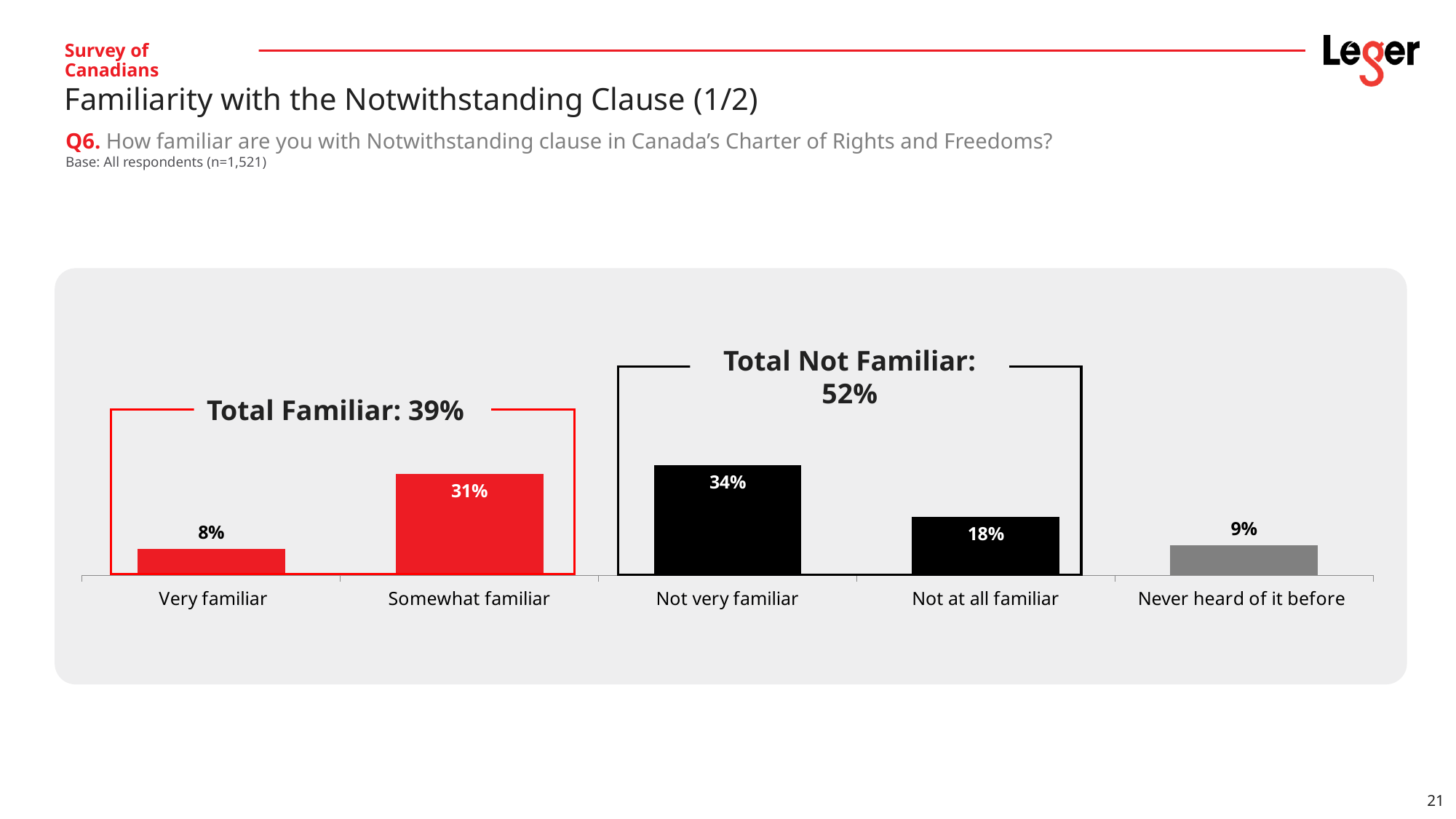
What percentage of respondents are not very familiar with the Notwithstanding clause? 34% Which is larger: the percentage for Somewhat familiar or the percentage for Not at all familiar? Somewhat familiar What percentage of respondents are somewhat familiar with the Notwithstanding clause? 31% What is the difference between the percentage for Not very familiar and the percentage for Not at all familiar? 16% What is the Total Familiar percentage shown on the chart? 39% Which category has the lowest percentage of respondents? Very familiar What is the Total Not Familiar percentage shown on the chart? 52% How many categories are shown on the chart? 5 What kind of chart is shown on the slide? Bar chart Which category has the highest percentage of respondents? Not very familiar What percentage of respondents are very familiar with the Notwithstanding clause? 8% What percentage of respondents have never heard of the Notwithstanding clause before? 9%